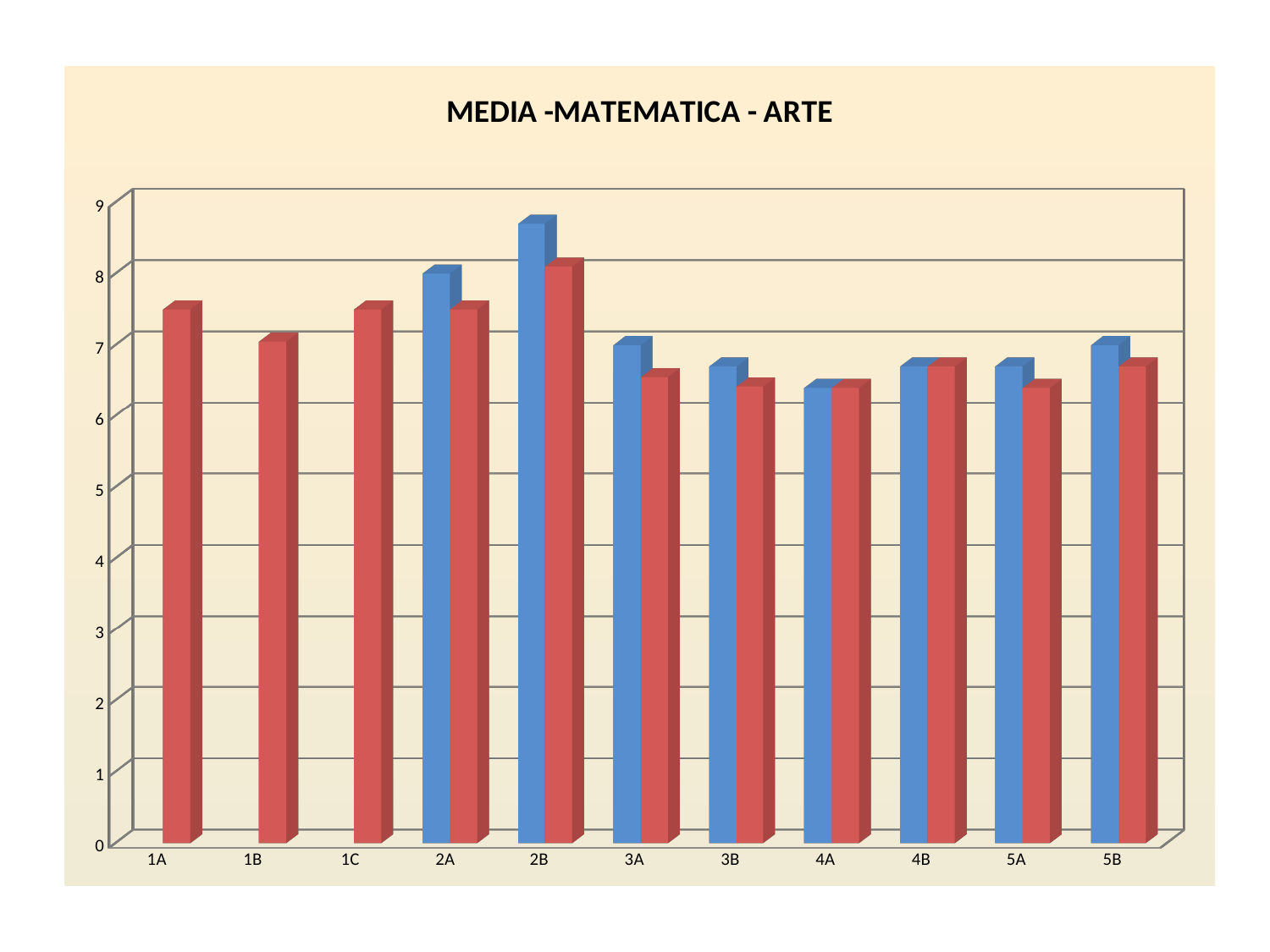
How many categories are shown on the x axis? 11 Which red bar is taller, 1A or 3A? 1A For 2B, which bar is taller, the blue one or the red one? blue Is the blue bar for 2B greater or less than 8? greater What kind of chart is shown on the slide? bar chart Is the red bar for 1A greater or less than 7? greater What is the title of the chart? MEDIA -MATEMATICA - ARTE Which category has the shortest blue bar? 4A Is the red bar for 3A greater or less than 7? less Which categories have only a red bar and no blue bar? 1A, 1B, 1C Which category has the tallest red bar? 2B Which category has the tallest blue bar? 2B